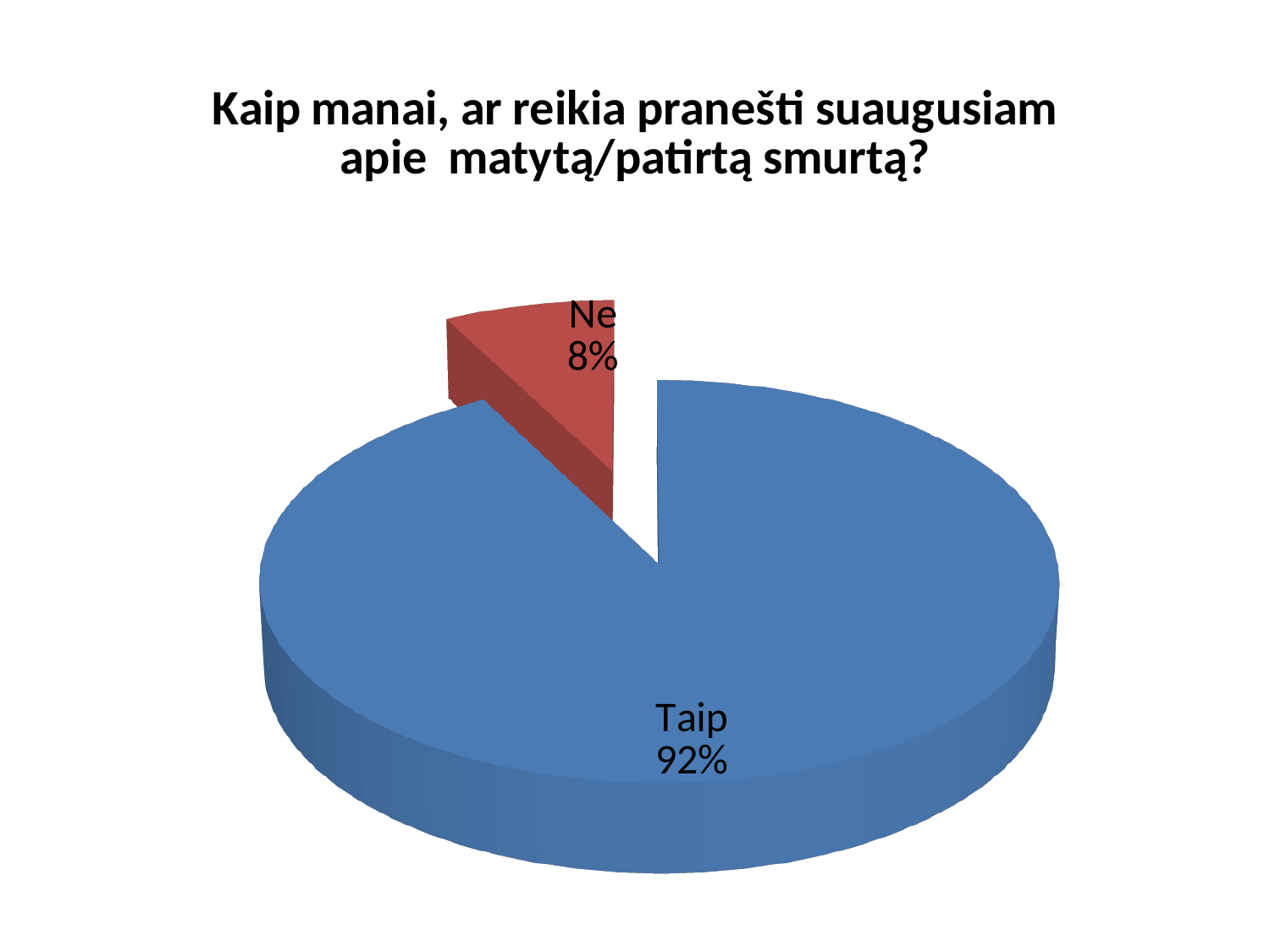
Which slice is the smallest? Ne Which is larger, the "Taip" slice or the "Ne" slice? Taip What share of the pie does "Ne" represent? 8% Which slice is the largest? Taip What type of chart is shown on the slide? pie chart What share of the pie does "Taip" represent? 92% What is the difference in percentage points between "Taip" and "Ne"? 84 What colour is the "Ne" slice? red How many slices does the pie chart have? 2 What is the title of the chart? Kaip manai, ar reikia pranešti suaugusiam apie matytą/patirtą smurtą?